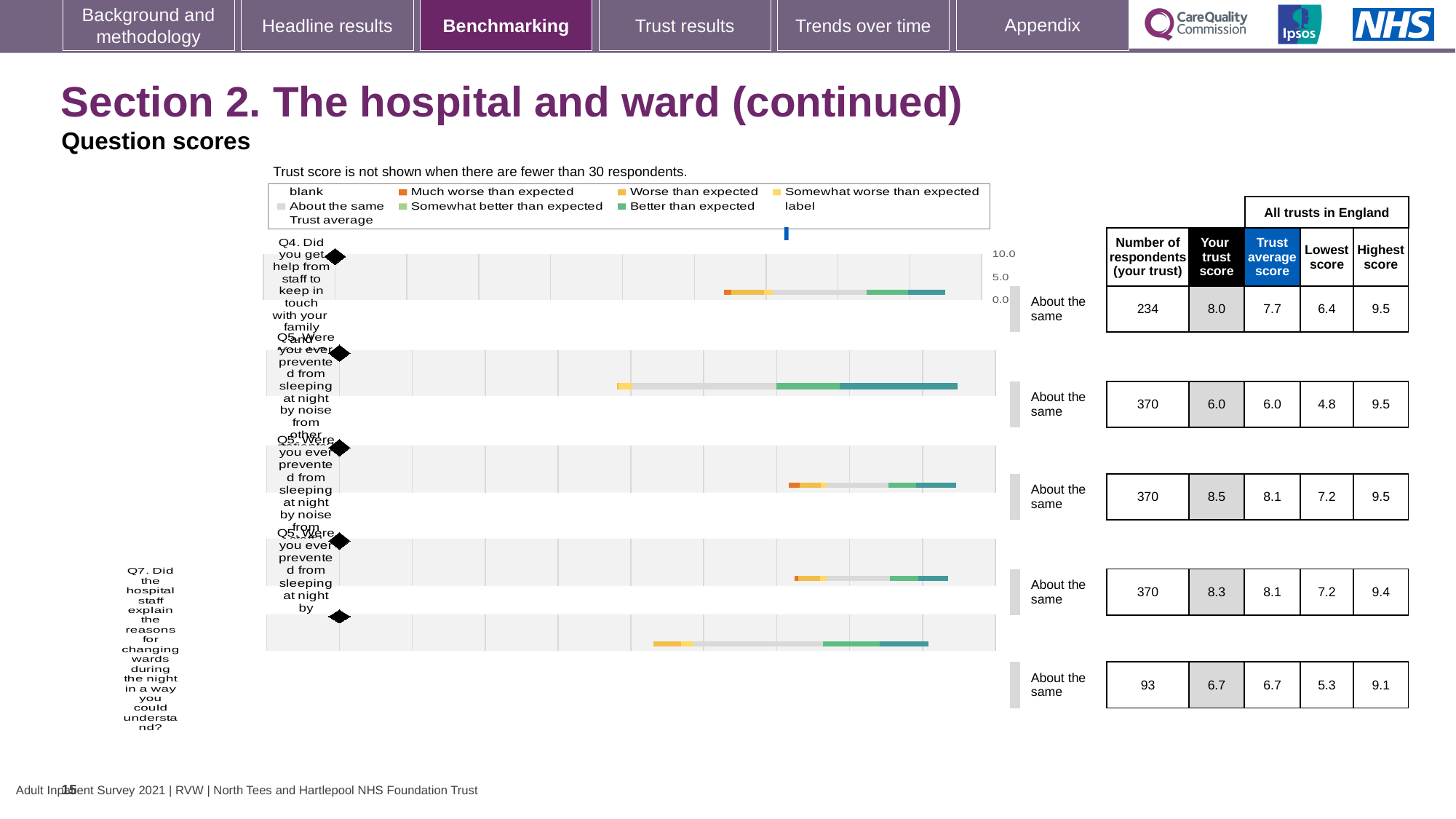
What is the trust score for Q4 (help from staff to keep in touch with family and friends)? 8.0 What is the trust score for the third row of the chart? 8.5 How many question rows (bars) are plotted in the chart? 5 What is the trust average score for Q4 (help from staff to keep in touch with family and friends)? 7.7 What is the highest score across all trusts in England for Q7 (changing wards during the night)? 9.1 What is the lowest score across all trusts in England for the second row of the chart? 4.8 How many respondents answered Q4 (help from staff to keep in touch with family and friends) at this trust? 234 What is the trust score for Q7 (did hospital staff explain the reasons for changing wards during the night)? 6.7 What is the difference between the trust score and the trust average score for Q4 (help from staff to keep in touch with family and friends)? 0.3 What benchmark category is shown for Q4 (help from staff to keep in touch with family and friends)? About the same What kind of chart is used to show the question scores on this slide? bar chart Which row has the lowest trust score: the first row (Q4) or the last row (Q7)? Q7